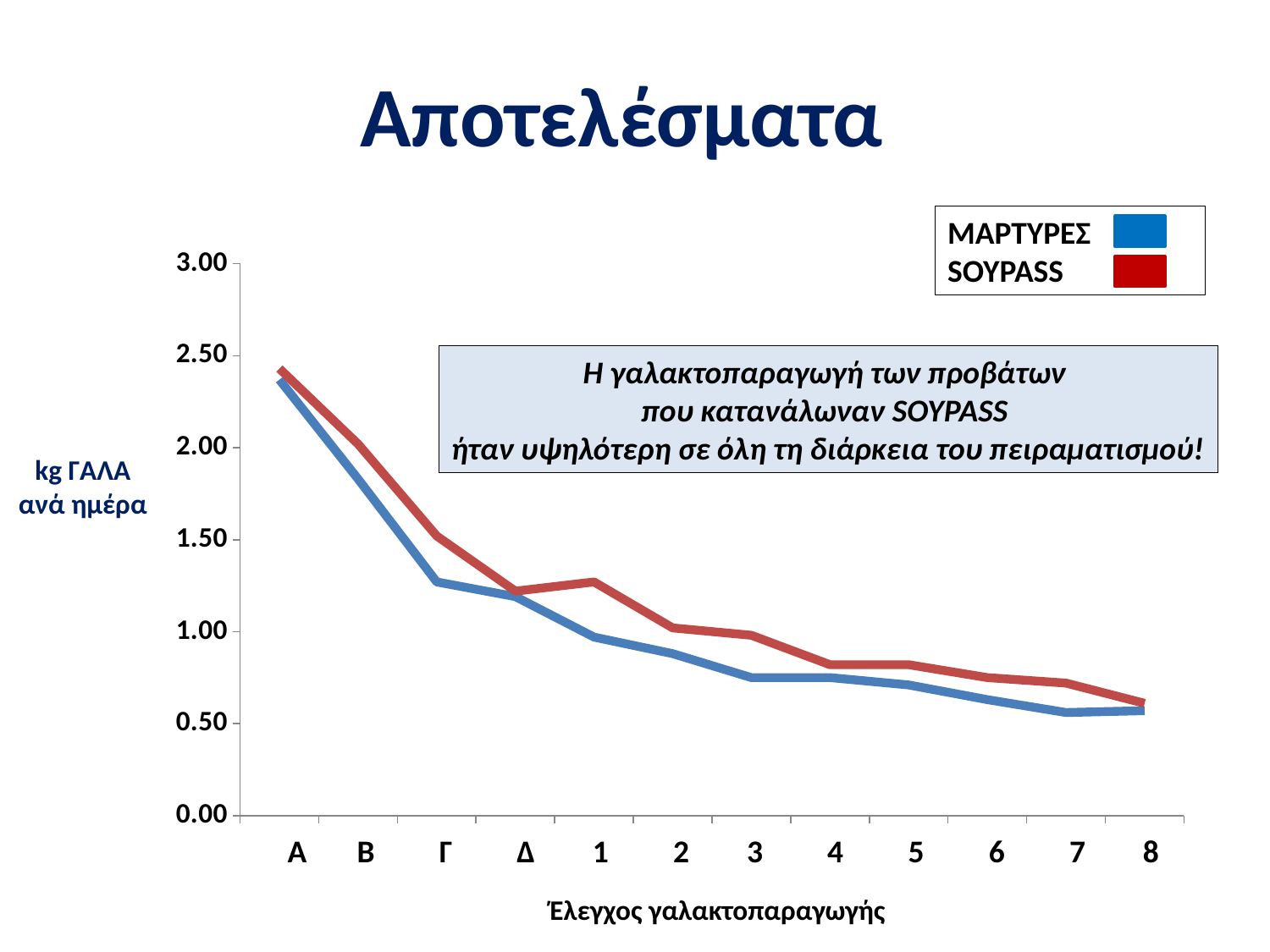
Is the value for ΜΑΡΤΥΡΕΣ at Β greater or less than 1.50? greater What kind of chart is shown on the slide? line chart At category 1, which series has the higher value, ΜΑΡΤΥΡΕΣ or SOYPASS? SOYPASS Is the value for SOYPASS at Α greater or less than 2.00? greater How many categories are shown along the x axis? 12 What is the label of the y axis? kg ΓΑΛΑ ανά ημέρα For the SOYPASS series, which category has the highest value? Α Do the values for SOYPASS rise or fall along the x axis from Α to 8? fall Is the value for ΜΑΡΤΥΡΕΣ at 8 greater or less than 1.00? less How many series does the legend list? 2 At category Γ, which series has the higher value, ΜΑΡΤΥΡΕΣ or SOYPASS? SOYPASS